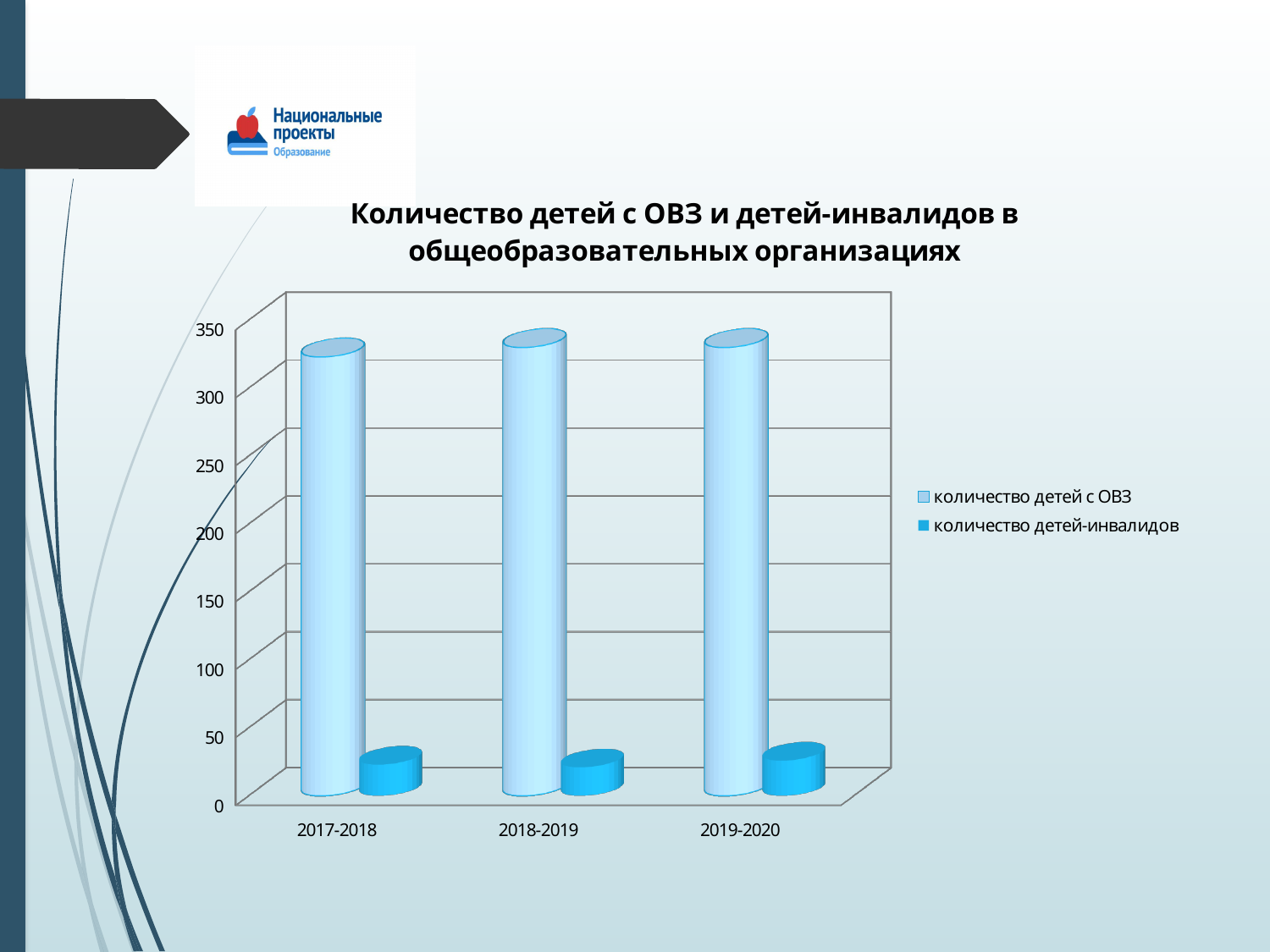
In 2018-2019, which series has the larger value: количество детей с ОВЗ or количество детей-инвалидов? количество детей с ОВЗ What kind of chart is shown on the slide? bar chart Is the value for количество детей с ОВЗ in 2019-2020 greater or less than 250? greater Is the value for количество детей с ОВЗ in 2017-2018 greater or less than 300? greater What is the title of the chart? Количество детей с ОВЗ и детей-инвалидов в общеобразовательных организациях Is the value for количество детей с ОВЗ in 2018-2019 greater or less than 350? less How many categories are shown on the x axis? 3 How many series does the legend list? 2 In 2017-2018, which series has the smaller value: количество детей с ОВЗ or количество детей-инвалидов? количество детей-инвалидов Which series is shown in the darker blue colour in the legend? количество детей-инвалидов